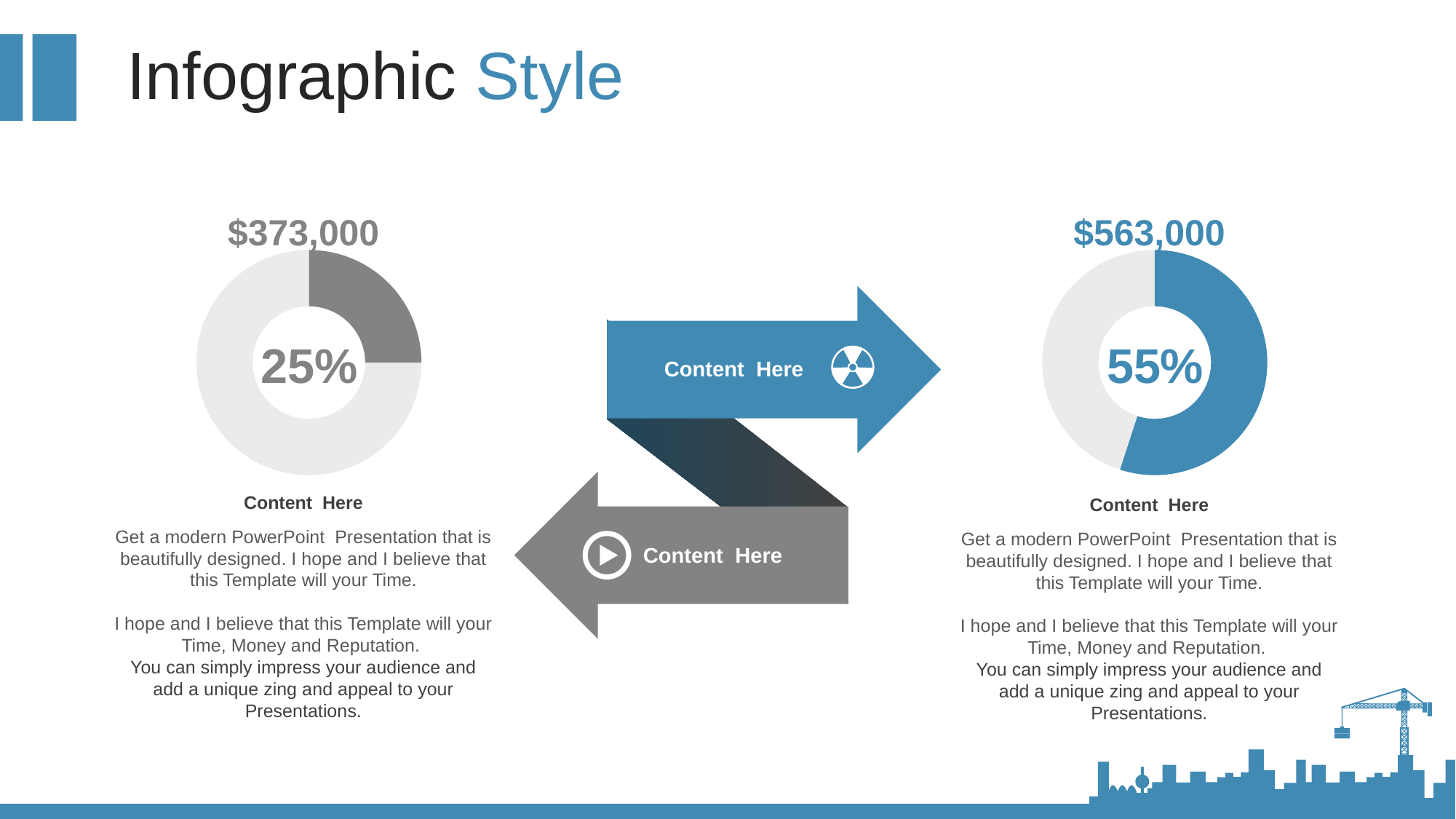
Which donut chart shows the larger percentage, the left one or the right one? The right one Which donut chart has the smaller dollar value above it? The left one What kind of chart is used on the left and right of the slide? Donut chart What is the difference between the dollar values above the right and left donut charts? $190,000 What is the difference in percentage points between the right donut chart (55%) and the left donut chart (25%)? 30 percentage points What percentage is shown in the centre of the left donut chart? 25% What dollar value is printed above the left donut chart? $373,000 Is the filled portion of the right donut chart more or less than half of the ring? More What percentage is shown in the centre of the right donut chart? 55% What colour is the filled segment of the left donut chart? Grey How many donut charts are on the slide? 2 What dollar value is printed above the right donut chart? $563,000